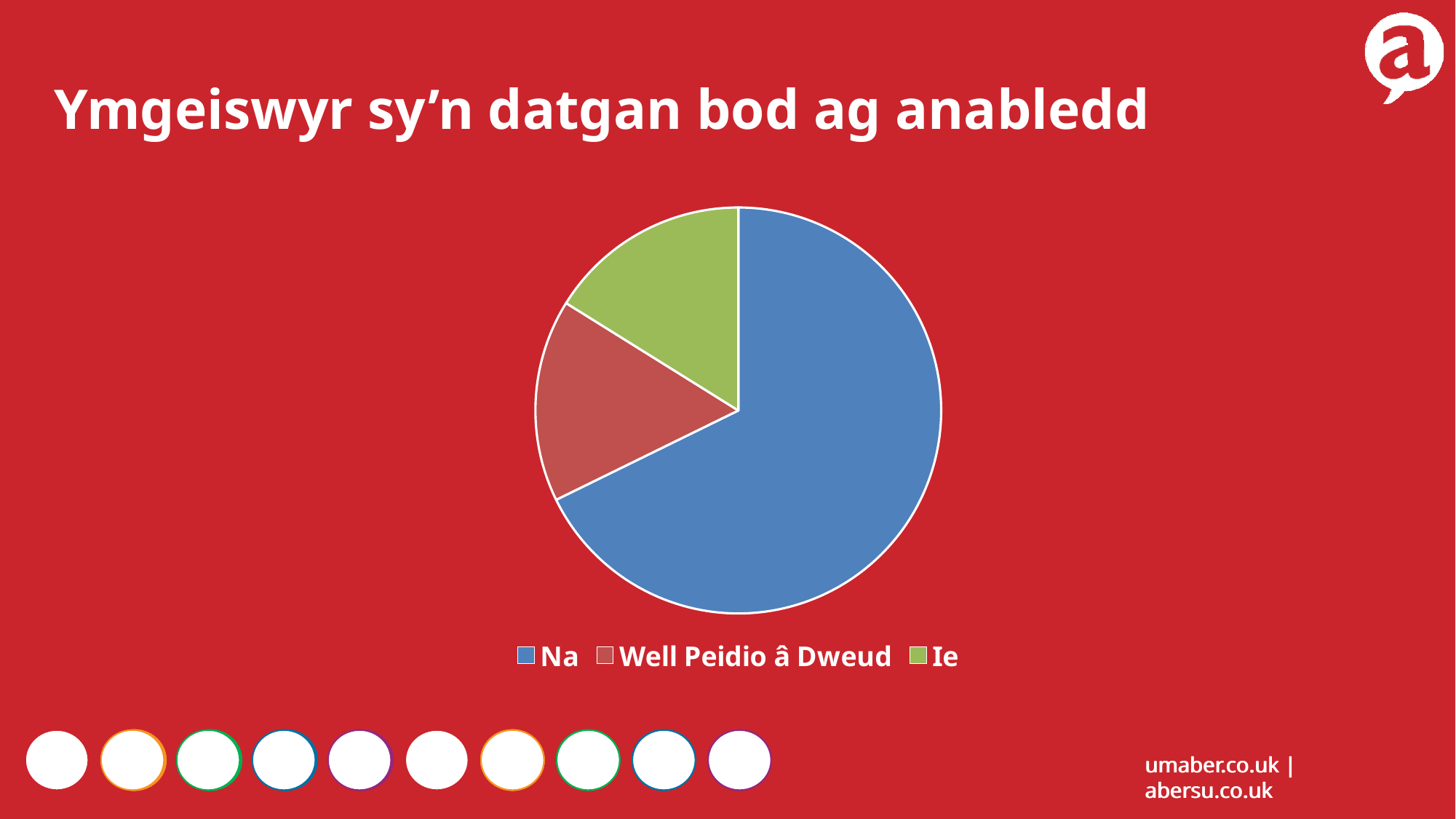
Which category has the largest slice of the pie chart? Na How many entries does the legend of the pie chart list? 3 Which colour represents the category Ie in the pie chart? green Which slice is larger, Na or Well Peidio â Dweud? Na Which slice is larger, Na or Ie? Na What is the title of the slide containing the pie chart? Ymgeiswyr sy’n datgan bod ag anabledd How many slices does the pie chart have? 3 What kind of chart is shown on the slide? pie chart